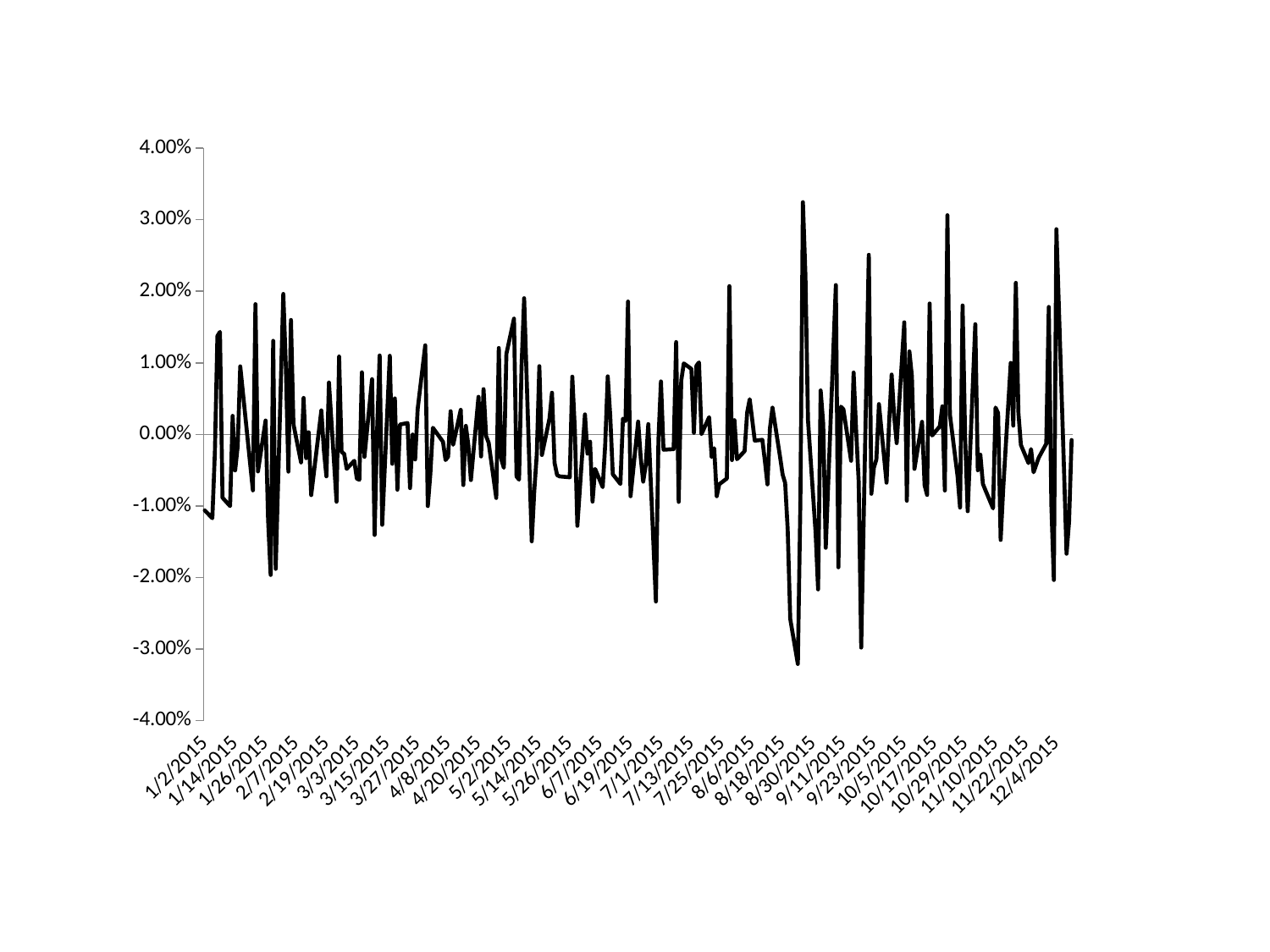
Is the peak of the line near 9/23/2015 greater or less than 2.00%? greater Is the peak of the line near 12/4/2015 greater or less than 3.00%? less How many lines (series) are plotted on the chart? 1 What is the first date label on the horizontal axis? 1/2/2015 What is the last date label on the horizontal axis? 12/4/2015 Does the line ever reach 4.00% on the chart? No How many date labels are shown on the horizontal axis? 29 What kind of chart is shown on the slide? line chart What is the highest value shown on the vertical axis? 4.00% What is the lowest value shown on the vertical axis? -4.00%